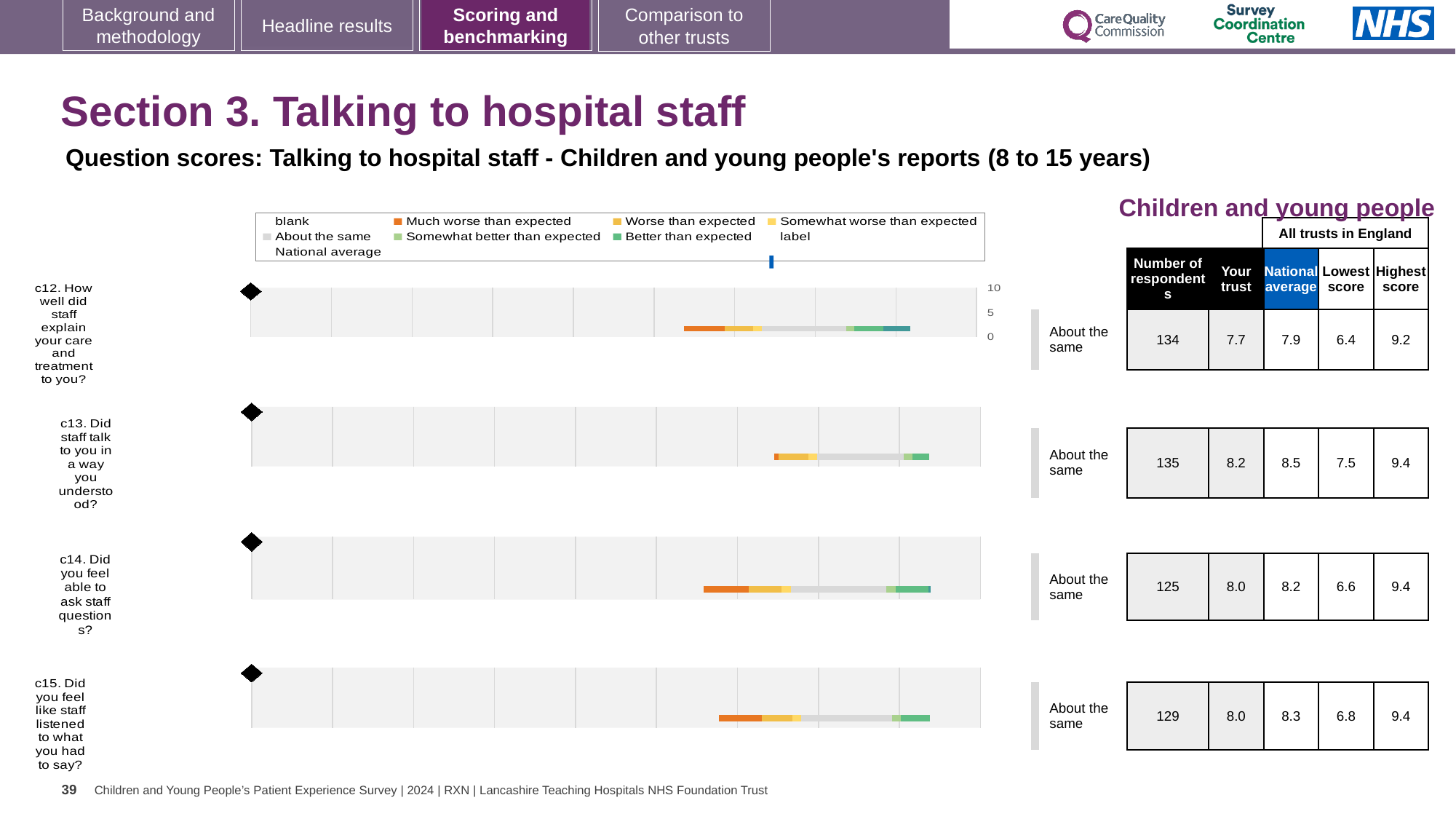
For c14, which is larger: the 'Your trust' score or the national average? National average How many questions (c12 to c15) are plotted on the slide? 4 Which question has the lowest 'Lowest score' across all trusts in England? c12 For c12, what is the difference between the highest score (9.2) and the lowest score (6.4)? 2.8 For c13 (Did staff talk to you in a way you understood?), what is the national average score? 8.5 Which question has the highest 'Your trust' score? c13 What kind of chart is used to show the question scores on this slide? bar chart How many respondents are shown for c14 (Did you feel able to ask staff questions?)? 125 What benchmark category is shown for c15 (Did you feel like staff listened to what you had to say?)? About the same For c12 (How well did staff explain your care and treatment to you?), what is the 'Your trust' score? 7.7 For c13, how much higher is the national average than the 'Your trust' score? 0.3 In the legend, which colour represents 'Much worse than expected'? Orange